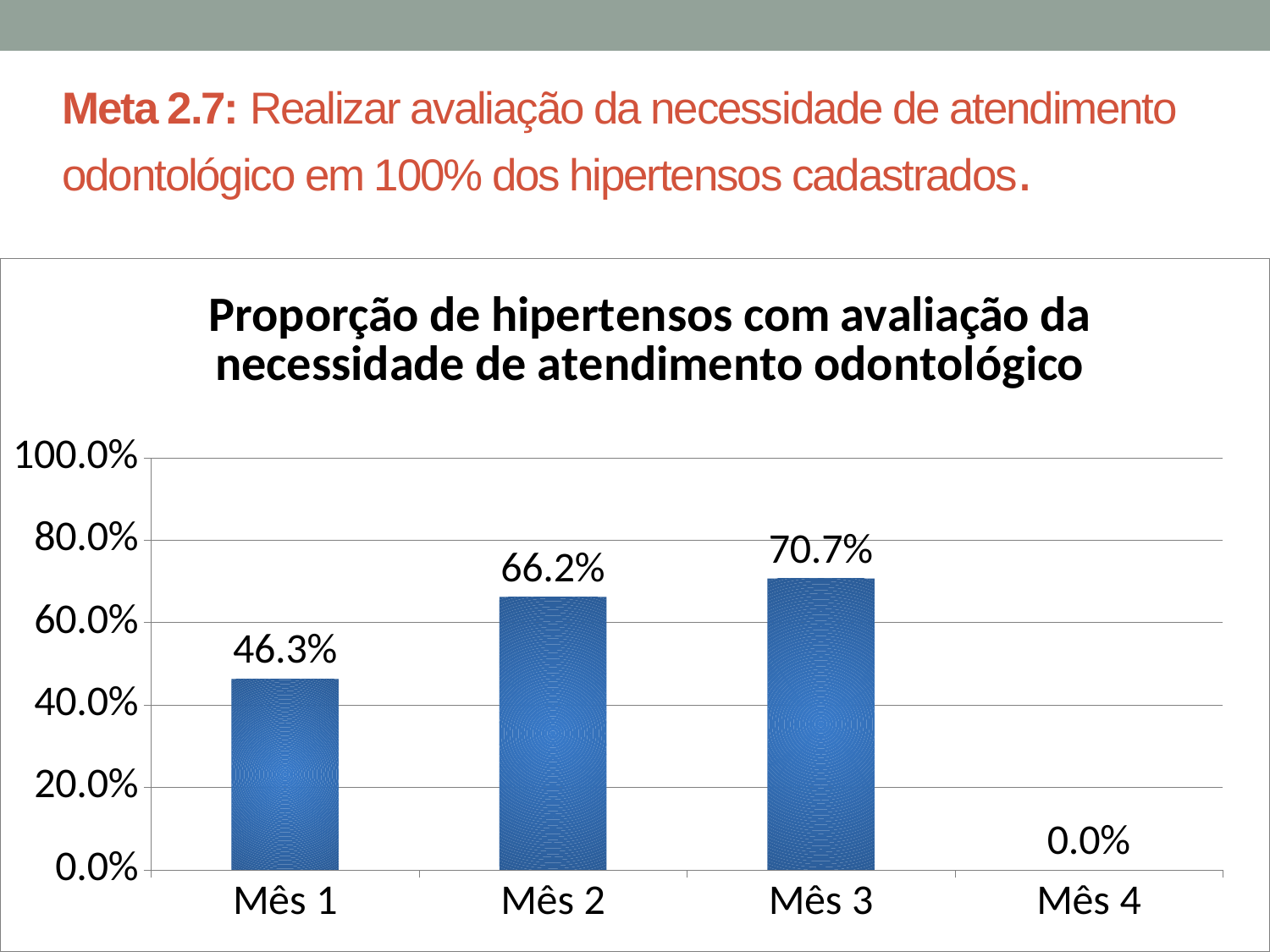
How many months are shown on the x axis? 4 What is the difference between the values for Mês 2 and Mês 1? 19.9% What is the value for Mês 3? 70.7% Which month has the highest value? Mês 3 What is the title of the chart? Proporção de hipertensos com avaliação da necessidade de atendimento odontológico What is the value for Mês 1? 46.3% Which month has the lowest value? Mês 4 What is the value for Mês 2? 66.2% Which is larger, the value for Mês 1 or the value for Mês 2? Mês 2 What kind of chart is shown on the slide? Bar chart What is the value for Mês 4? 0.0% What is the difference between the values for Mês 3 and Mês 2? 4.5%